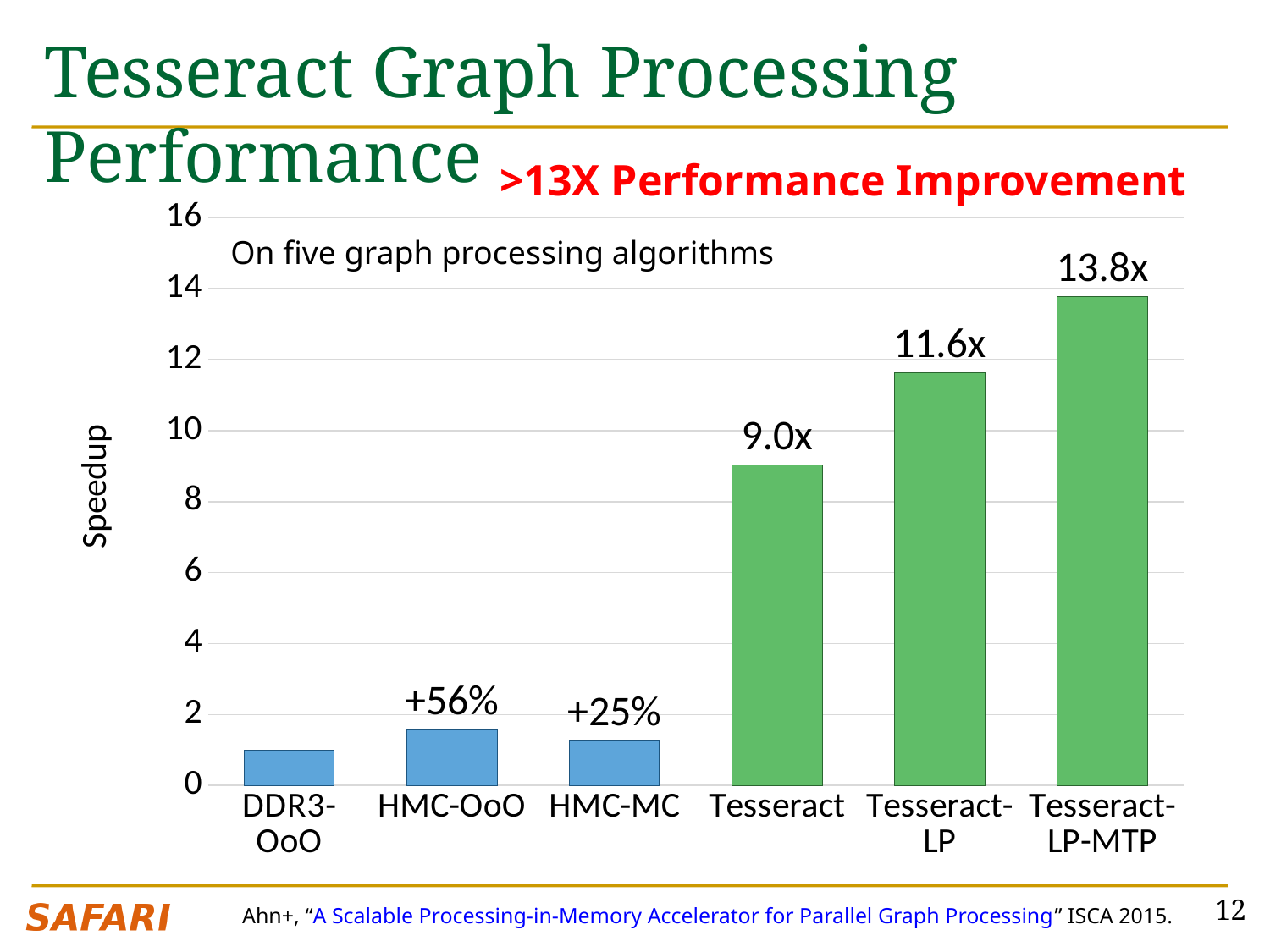
How many categories are shown on the x axis? 6 Is the speedup for DDR3-OoO greater or less than 2? less What kind of chart is shown on the slide? bar chart What is the speedup shown for Tesseract? 9.0x Which category has the lowest speedup? DDR3-OoO Which category has the highest speedup? Tesseract-LP-MTP What is the speedup shown for Tesseract-LP? 11.6x What is the difference in speedup between Tesseract-LP-MTP and Tesseract? 4.8x What label is printed above the HMC-MC bar? +25% What is the speedup shown for Tesseract-LP-MTP? 13.8x What label is printed above the HMC-OoO bar? +56% Which has a larger speedup, HMC-OoO or Tesseract-LP? Tesseract-LP